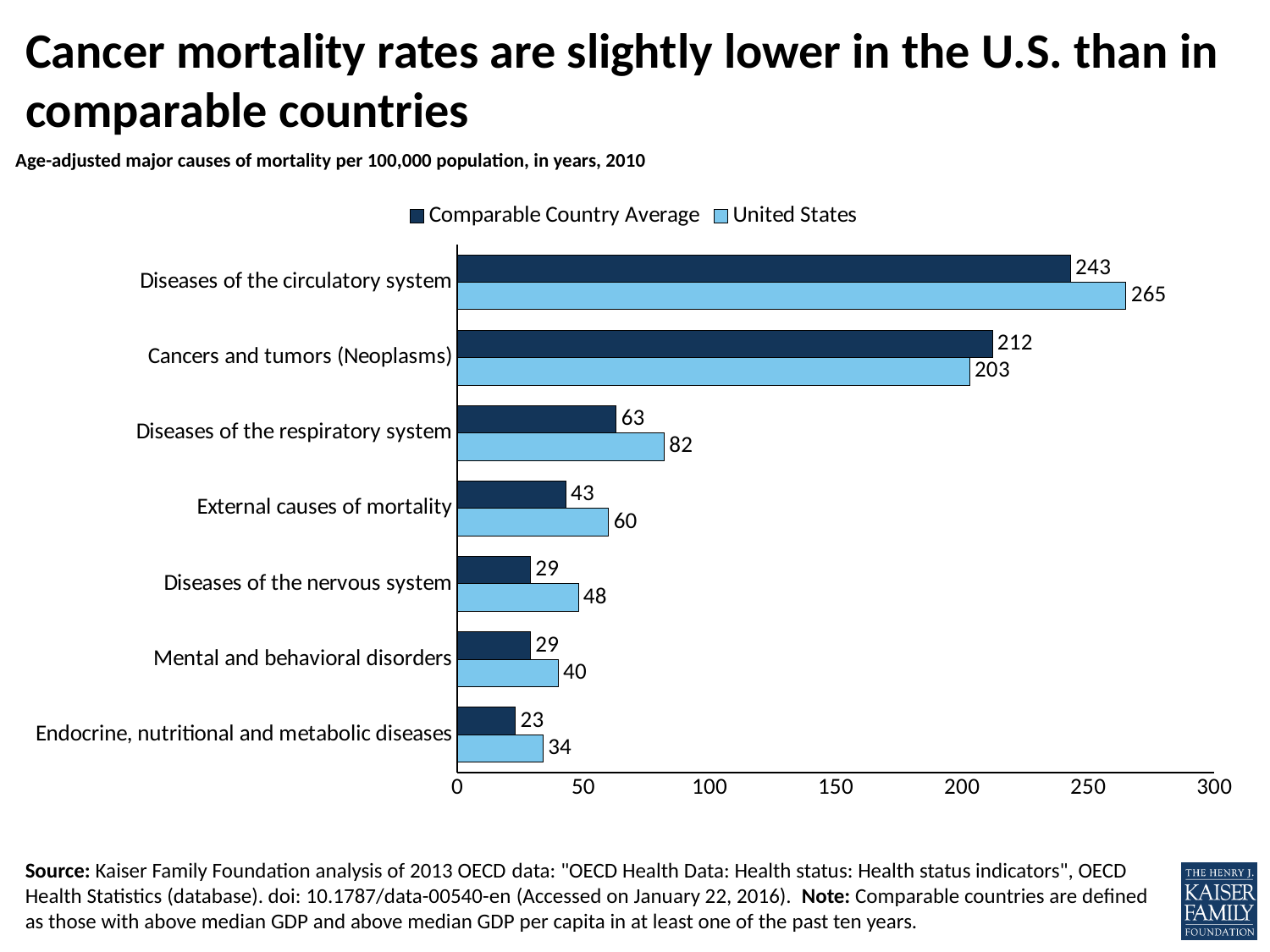
What kind of chart is shown on the slide? bar chart Which category has the highest United States value? Diseases of the circulatory system For External causes of mortality, which is larger: the United States value or the Comparable Country Average value? United States How many series does the legend list? 2 What is the United States value for Diseases of the circulatory system? 265 What is the difference between the Comparable Country Average and United States values for Cancers and tumors (Neoplasms)? 9 Which category has the lowest Comparable Country Average value? Endocrine, nutritional and metabolic diseases What is the difference between the United States and Comparable Country Average values for Diseases of the circulatory system? 22 Is the United States value for Diseases of the nervous system greater or less than 50? less What is the Comparable Country Average value for Cancers and tumors (Neoplasms)? 212 How many categories are shown on the chart? 7 What is the United States value for Diseases of the respiratory system? 82